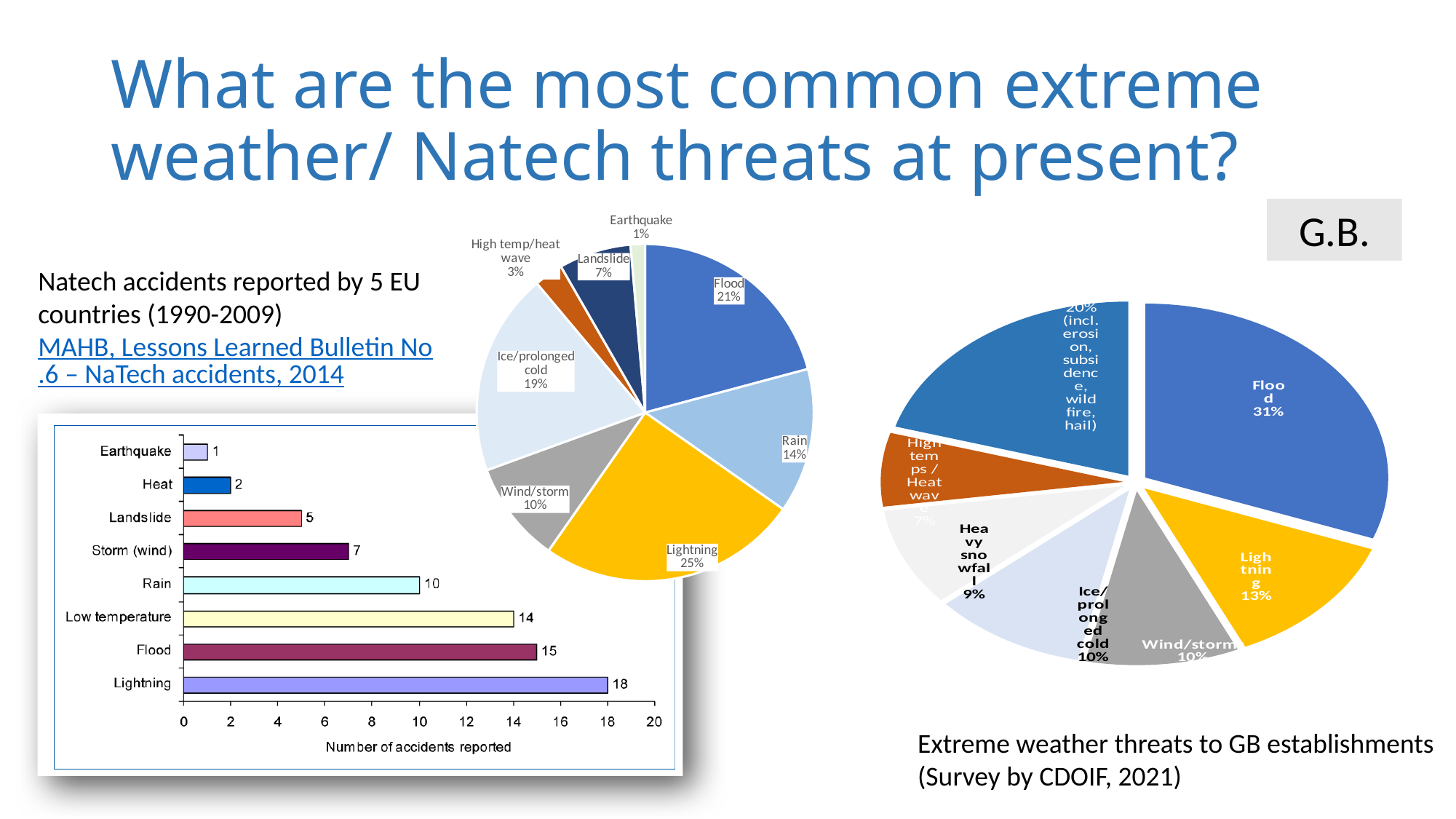
In the right pie chart (Extreme weather threats to GB establishments), what is the difference between the shares for Lightning and Heavy snowfall? 4% In the bar chart at the bottom left, how many accidents were reported for Flood? 15 In the bar chart at the bottom left, which category has the highest number of accidents reported? Lightning In the bar chart at the bottom left, which category has the lowest number of accidents reported? Earthquake In the right pie chart (Extreme weather threats to GB establishments), which category has the largest share? Flood What type of chart is the chart at the bottom left of the slide? Bar chart In the right pie chart (Extreme weather threats to GB establishments), what share does Flood have? 31% In the middle pie chart (Natech accidents reported by 5 EU countries), which category has the smallest share? Earthquake In the middle pie chart (Natech accidents reported by 5 EU countries), what share does Lightning have? 25% In the bar chart at the bottom left, what is the difference between the number of accidents for Lightning and for Rain? 8 In the bar chart at the bottom left, how many categories are shown? 8 In the middle pie chart (Natech accidents reported by 5 EU countries), which is larger: Flood or Ice/prolonged cold? Flood